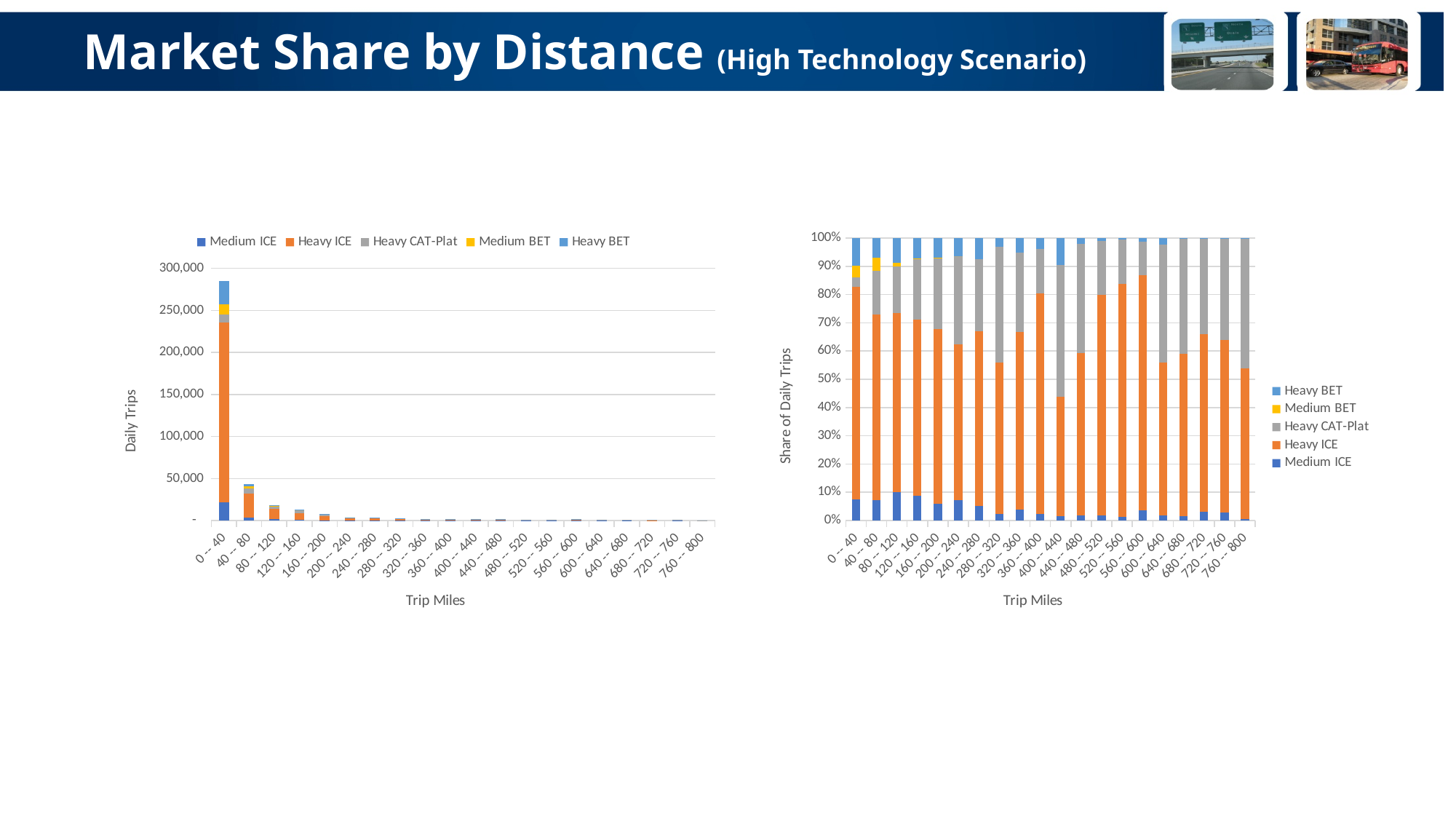
How many series does the legend of the left chart (Daily Trips) list? 5 In the left chart (Daily Trips), do total daily trips generally rise or fall as Trip Miles increase along the x axis? fall In the right chart (Share of Daily Trips), which has the larger Heavy ICE share: the 0 -- 40 category or the 400 -- 440 category? 0 -- 40 In the right chart (Share of Daily Trips), is the Heavy ICE share for the 560 -- 600 category greater or less than 80%? greater In the left chart (Daily Trips), which Trip Miles category has the highest total daily trips? 0 -- 40 In the right chart (Share of Daily Trips), which series is shown in yellow? Medium BET How many Trip Miles categories are shown on the x axis of the right chart (Share of Daily Trips)? 20 What kind of chart is the left chart showing Daily Trips by Trip Miles? Stacked bar chart What is the y-axis title of the right chart? Share of Daily Trips In the right chart (Share of Daily Trips), is the Heavy ICE share for the 400 -- 440 category greater or less than 50%? less In the left chart (Daily Trips), is the total for the 40 -- 80 category greater or less than 50,000? less